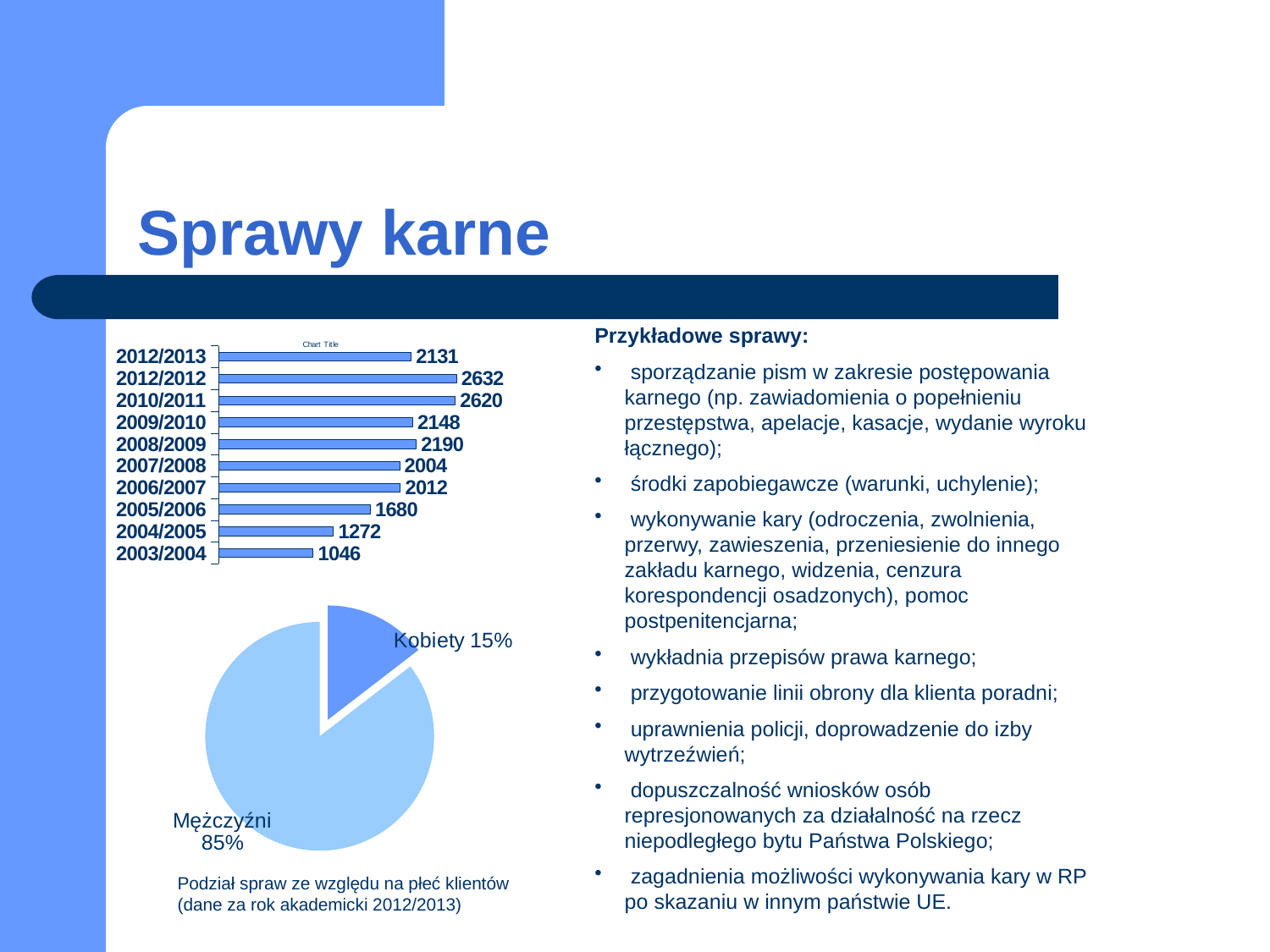
On the bar chart at the top left, what is the value for 2012/2013? 2131 What kind of chart is the chart at the bottom left of the slide? pie chart On the pie chart at the bottom left, which slice is larger, Kobiety or Mężczyźni? Mężczyźni On the bar chart at the top left, what is the value for 2003/2004? 1046 What kind of chart is the chart at the top left of the slide? bar chart On the bar chart at the top left, what is the difference between the values for 2010/2011 and 2009/2010? 472 On the bar chart at the top left, what is the value for 2005/2006? 1680 On the bar chart at the top left, which category has the lowest value? 2003/2004 On the bar chart at the top left, which category has the highest value? 2012/2012 On the bar chart at the top left, which is larger, the value for 2008/2009 or the value for 2007/2008? 2008/2009 How many categories are shown on the bar chart at the top left? 10 On the pie chart at the bottom left, what share of cases is for Kobiety? 15%